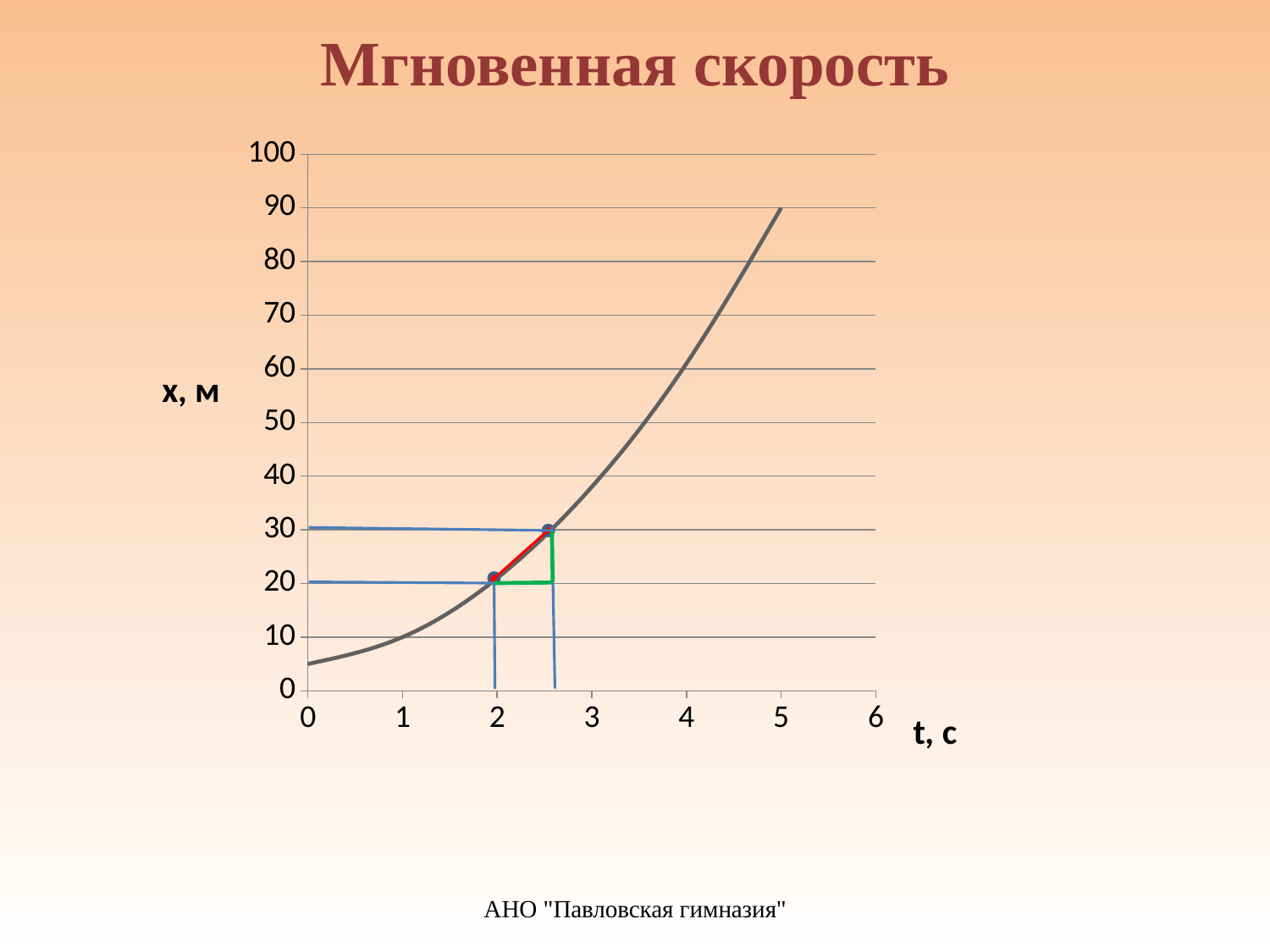
What x value does the horizontal guide line through the upper marked point correspond to? 30 Is the value of x at t = 0 greater or less than 10? less What is the value of x at t = 5? 90 What kind of chart is shown on the slide? line chart Is the value of x at t = 3 greater or less than 30? greater Does the value of x rise or fall as t increases? rise What x value does the horizontal guide line through the lower marked point correspond to? 20 At which value of t is the plotted value of x lowest? 0 What is the label of the vertical axis? x, м At which value of t does the curve reach its highest plotted value? 5 Is the value of x at t = 4 greater or less than 50? greater What is the title of the chart? Мгновенная скорость